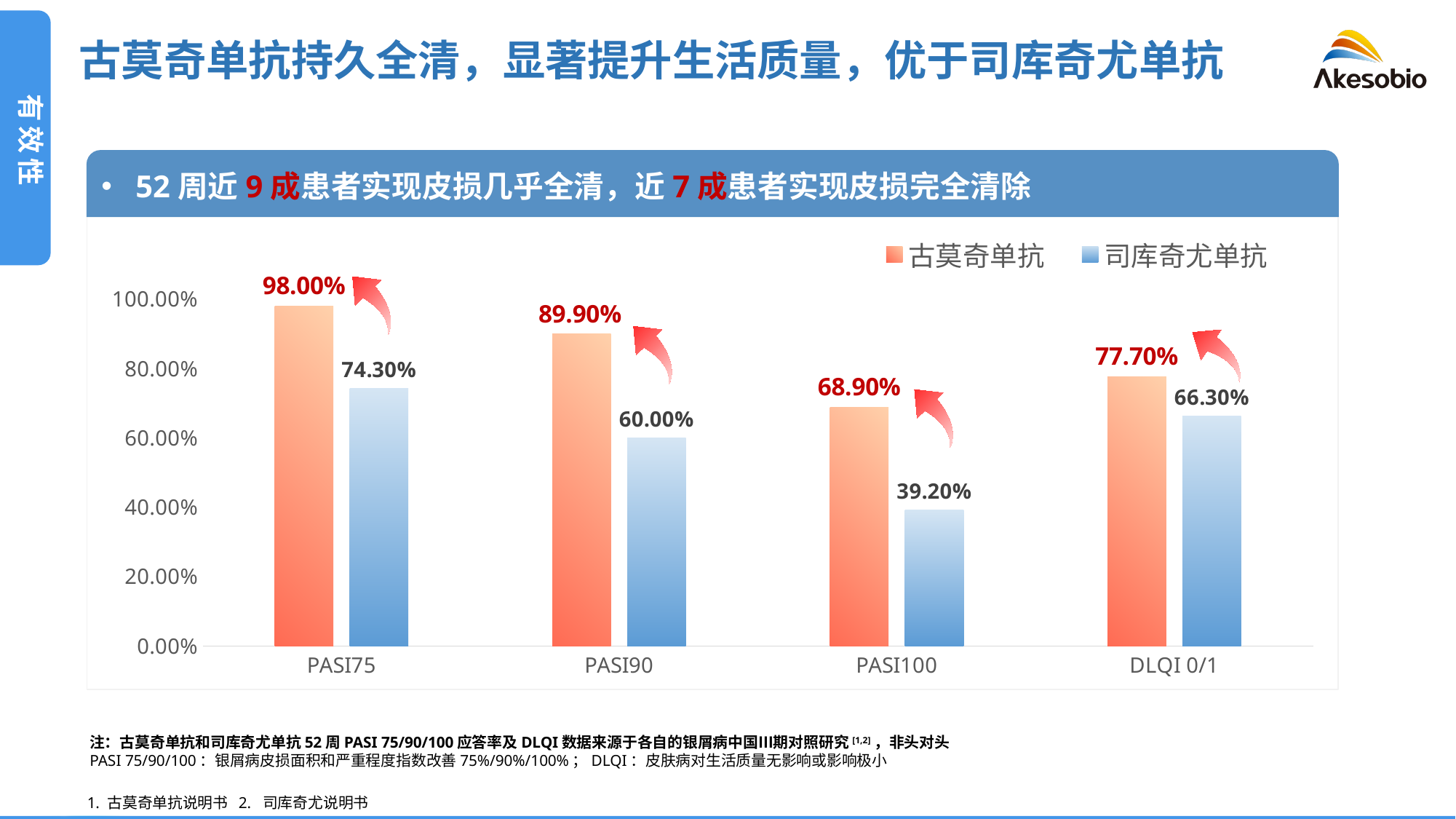
What is the value for 司库奇尤单抗 at PASI100? 39.20% What is the value for 古莫奇单抗 at DLQI 0/1? 77.70% How many categories are shown on the x axis? 4 Which category has the lowest value for 司库奇尤单抗? PASI100 What kind of chart is shown on the slide? Bar chart What is the value for 古莫奇单抗 at PASI75? 98.00% Which is larger at DLQI 0/1: 古莫奇单抗 or 司库奇尤单抗? 古莫奇单抗 What is the value for 司库奇尤单抗 at PASI90? 60.00% What is the difference between 古莫奇单抗 and 司库奇尤单抗 at PASI75? 23.70% How many series does the legend list? 2 Which category has the highest value for 古莫奇单抗? PASI75 What is the difference between 古莫奇单抗 and 司库奇尤单抗 at PASI100? 29.70%